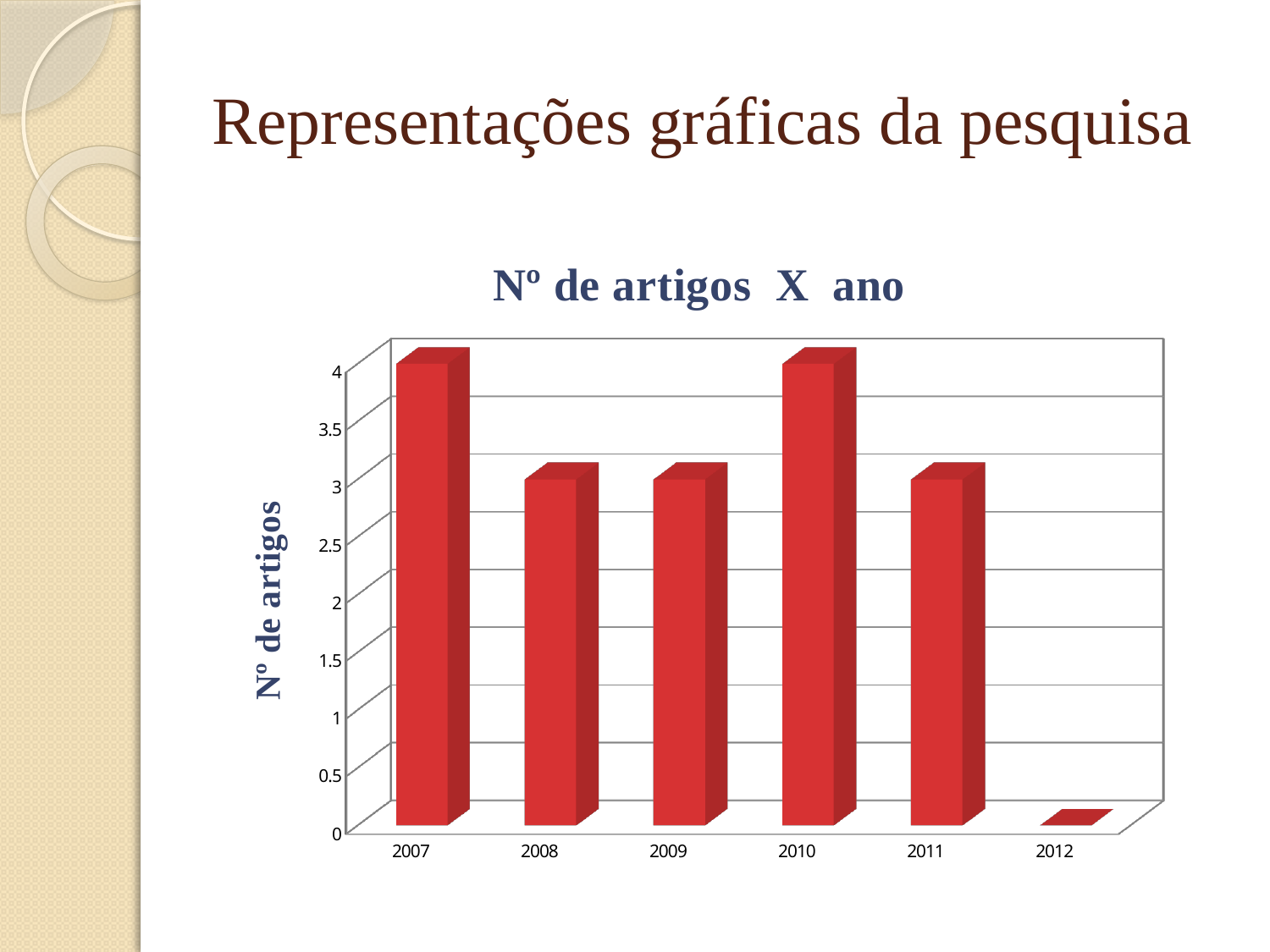
What is the number of articles for 2010? 4 Is the value for 2011 greater or less than 3.5? less What is the number of articles for 2012? 0 What kind of chart is shown on the slide? bar chart What is the label on the vertical axis of the chart? Nº de artigos What is the number of articles for 2007? 4 What is the title of the chart? Nº de artigos X ano Which year has more articles, 2007 or 2011? 2007 What is the number of articles for 2008? 3 What is the difference between the number of articles in 2010 and in 2009? 1 Which year has the lowest number of articles? 2012 How many years are shown on the x axis of the chart? 6